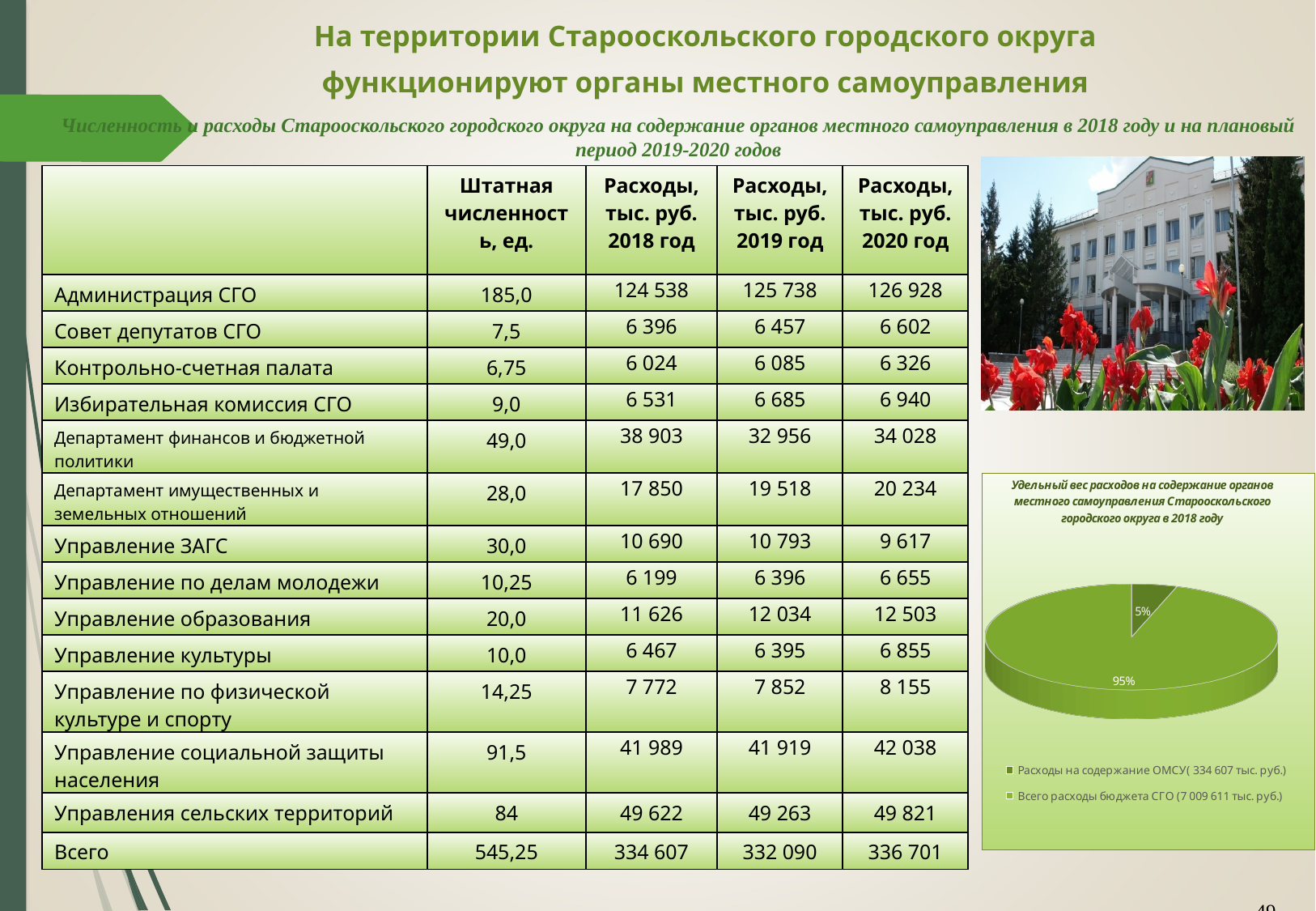
What kind of chart is shown on the right side of the slide? pie chart In the pie chart, what share is labelled for 'Всего расходы бюджета СГО'? 95% Which slice of the pie chart is the smallest? Расходы на содержание ОМСУ In the pie chart, which is larger: the share for 'Расходы на содержание ОМСУ' or the share for 'Всего расходы бюджета СГО'? Всего расходы бюджета СГО Which slice of the pie chart is the largest? Всего расходы бюджета СГО According to the pie chart legend, what amount in тыс. руб. is given for 'Всего расходы бюджета СГО'? 7 009 611 тыс. руб. How many slices does the pie chart have? 2 In the pie chart, what share is labelled for 'Расходы на содержание ОМСУ'? 5% Which year does the pie chart's title say the data refers to? 2018 How many entries does the legend of the pie chart list? 2 According to the pie chart legend, what amount in тыс. руб. is given for 'Расходы на содержание ОМСУ'? 334 607 тыс. руб. What is the difference in percentage points between the two slices of the pie chart? 90